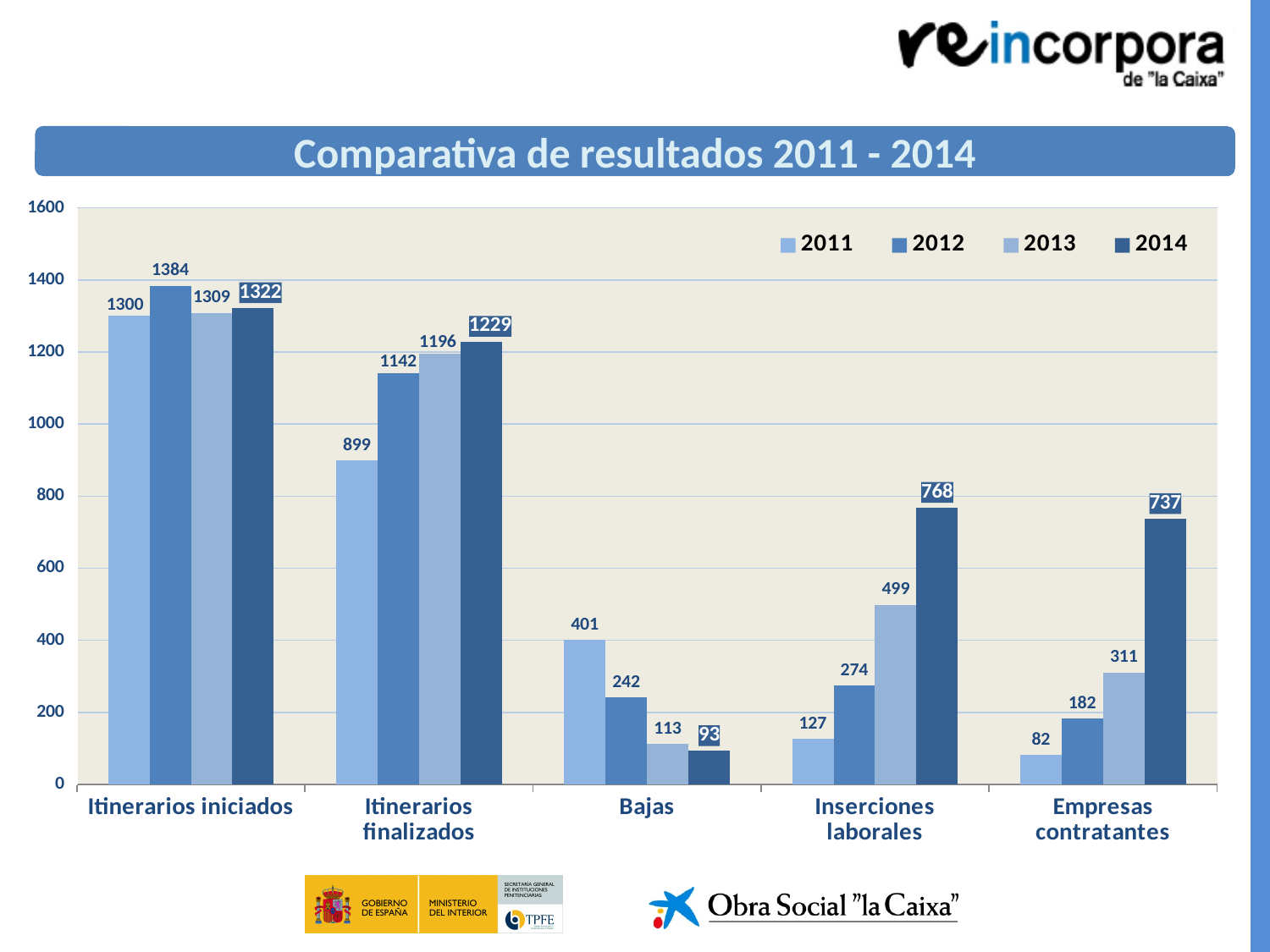
How many series does the legend list? 4 What is the value for Itinerarios iniciados in 2012? 1384 Which year has the highest value for Empresas contratantes? 2014 Do the values for Bajas rise or fall from 2011 to 2014? Fall Which year has the lowest value for Bajas? 2014 What is the title of the chart? Comparativa de resultados 2011 - 2014 How many categories are shown on the x axis? 5 Which is larger: Inserciones laborales in 2013 or Empresas contratantes in 2013? Inserciones laborales in 2013 What is the value for Bajas in 2011? 401 What is the difference between the 2014 and 2011 values for Itinerarios finalizados? 330 What is the value for Inserciones laborales in 2014? 768 What kind of chart is shown on the slide? Bar chart